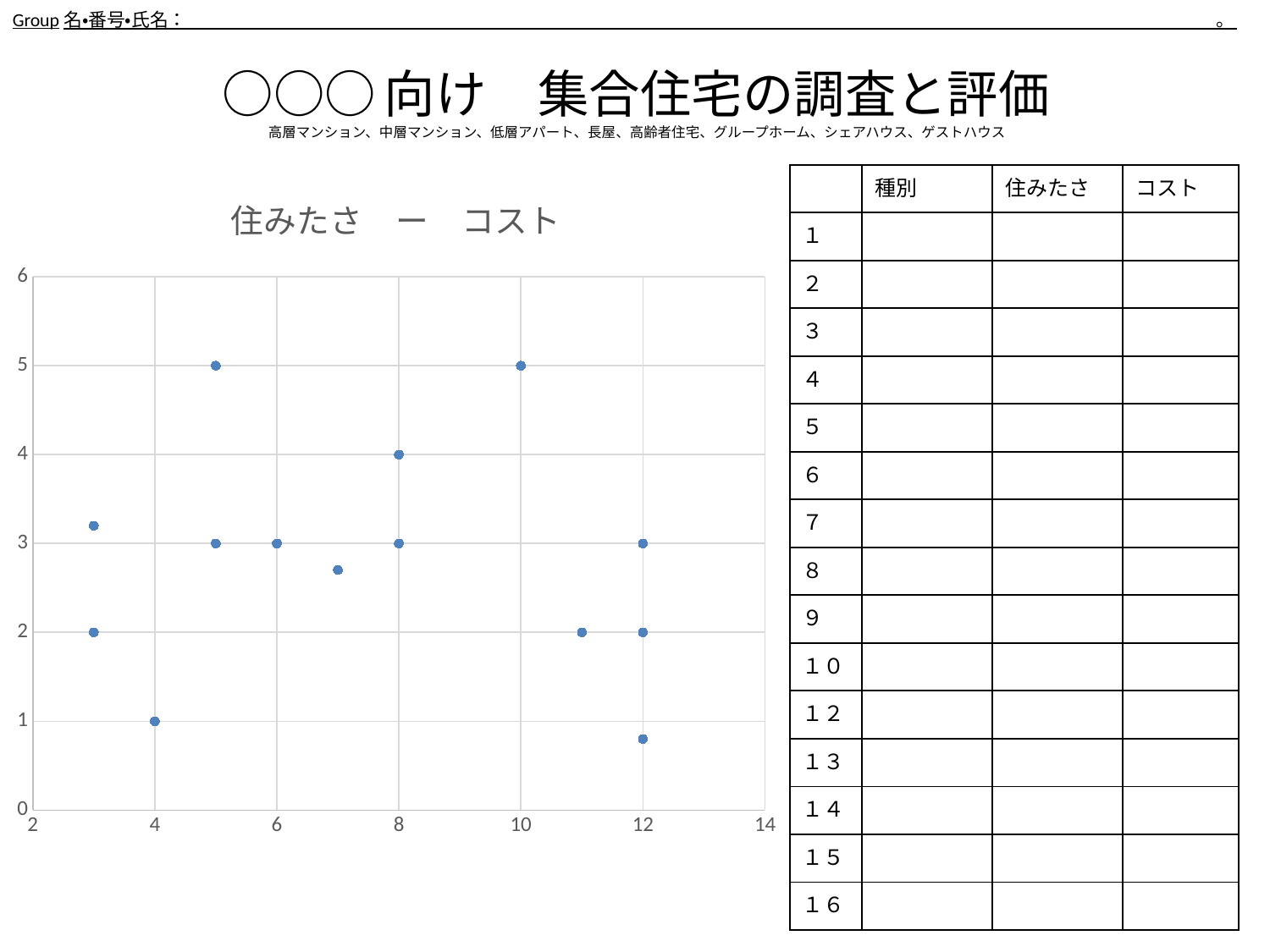
How many points are plotted at x = 12? 3 What is the y value of the point plotted at x = 4? 1 What is the title of the chart? 住みたさ ー コスト What is the highest y value reached by any point on the chart? 5 What is the largest x value at which points are plotted? 12 Is the y value of the lowest point at x = 12 greater or less than 1? less What is the y value of the point plotted at x = 10? 5 What is the maximum value shown on the x axis? 14 What is the y value of the point plotted at x = 11? 2 What kind of chart is shown on the slide? scatter chart Is the y value of the point at x = 7 greater or less than 3? less